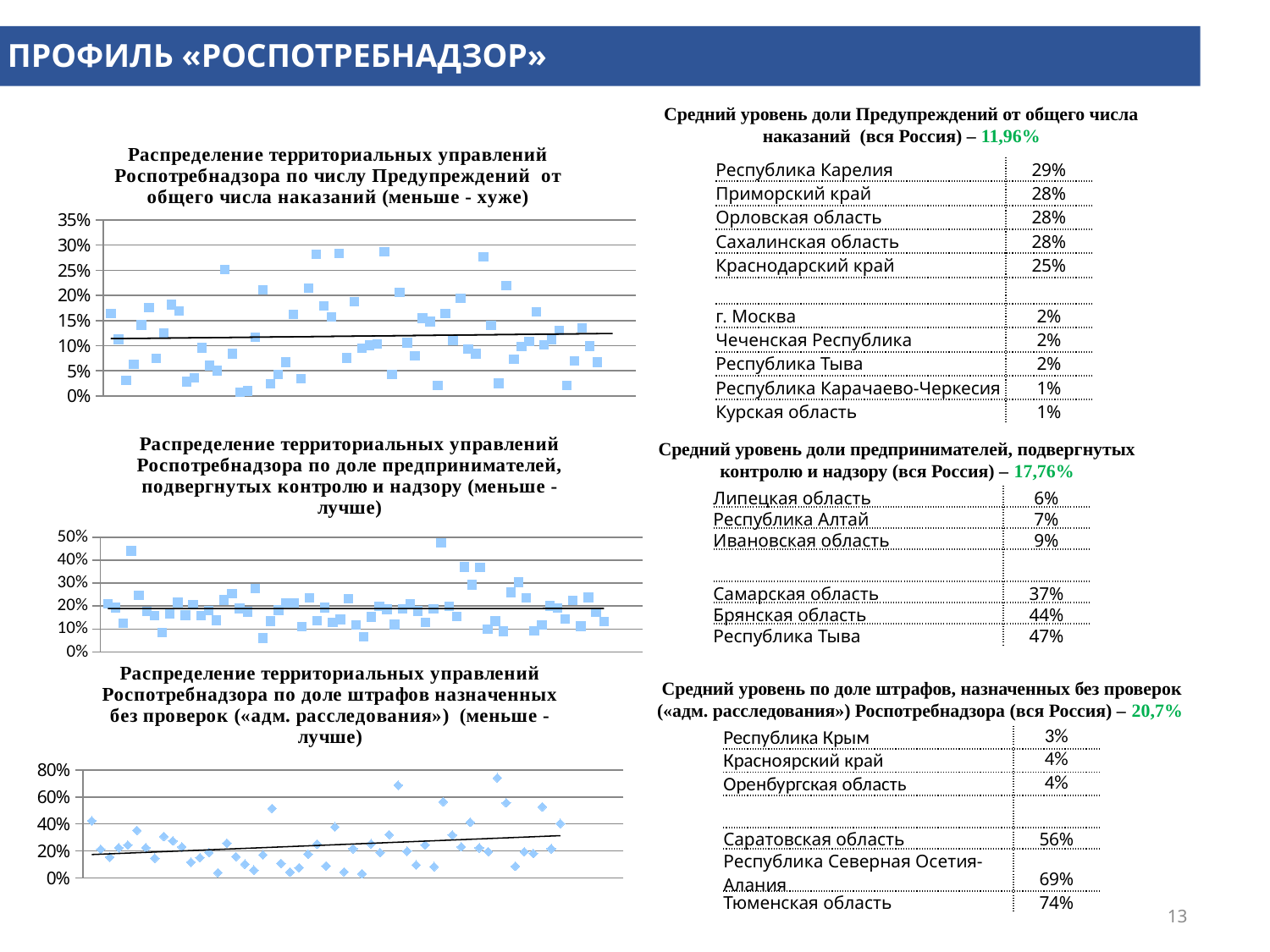
In the middle-left chart (share of entrepreneurs subject to control), is the highest plotted point greater or less than 40%? greater What is the highest value shown on the y-axis of the top-left chart (share of warnings)? 35% What kind of chart is the top-left chart about the share of warnings (Предупреждений) in total penalties? scatter chart How many charts are shown on the slide? 3 In the bottom-left chart (share of fines without inspections), does the trend line rise or fall from left to right? rises In the top-left chart (share of warnings), does the trend line rise or fall from left to right? rises What kind of chart is the bottom-left chart about the share of fines imposed without inspections? scatter chart In the top-left chart (share of warnings), is the highest plotted point greater or less than 25%? greater In the bottom-left chart (share of fines without inspections), is the highest plotted point greater or less than 60%? greater What is the highest value shown on the y-axis of the bottom-left chart (share of fines without inspections)? 80%